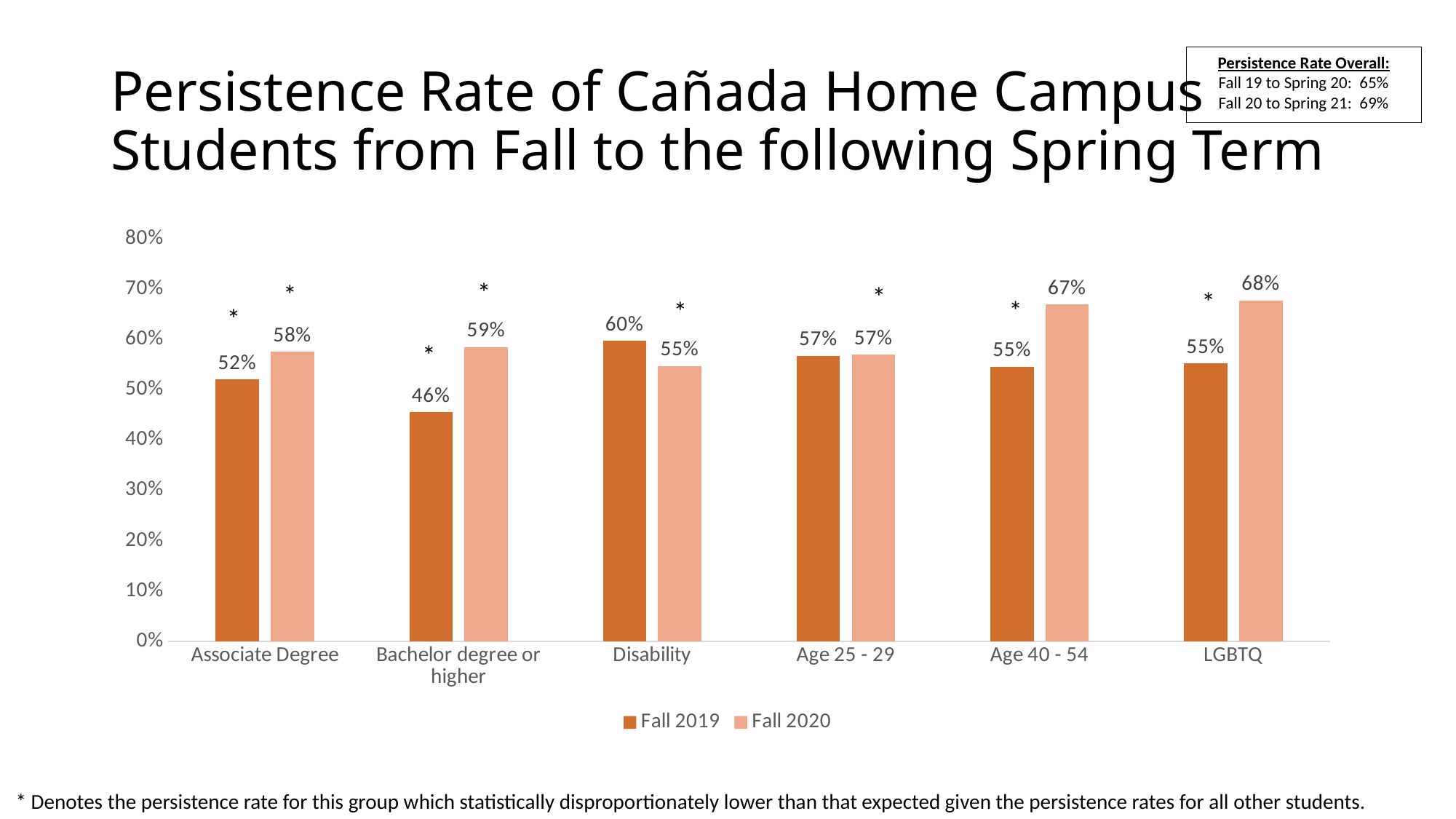
For the Disability group, which is larger: the Fall 2019 or the Fall 2020 persistence rate? Fall 2019 Which category has the highest Fall 2019 persistence rate? Disability What is the Fall 2019 persistence rate for Associate Degree students? 52% What is the difference between the Fall 2020 and Fall 2019 persistence rates for Bachelor degree or higher students? 13% What is the Fall 2019 persistence rate for Bachelor degree or higher students? 46% What is the Fall 2020 persistence rate for LGBTQ students? 68% Which category has the highest Fall 2020 persistence rate? LGBTQ Which category has the lowest Fall 2019 persistence rate? Bachelor degree or higher What is the Fall 2020 persistence rate for Age 40 - 54 students? 67% How many series does the legend list? 2 How many categories are shown on the x axis of the chart? 6 What kind of chart is shown on the slide? Bar chart